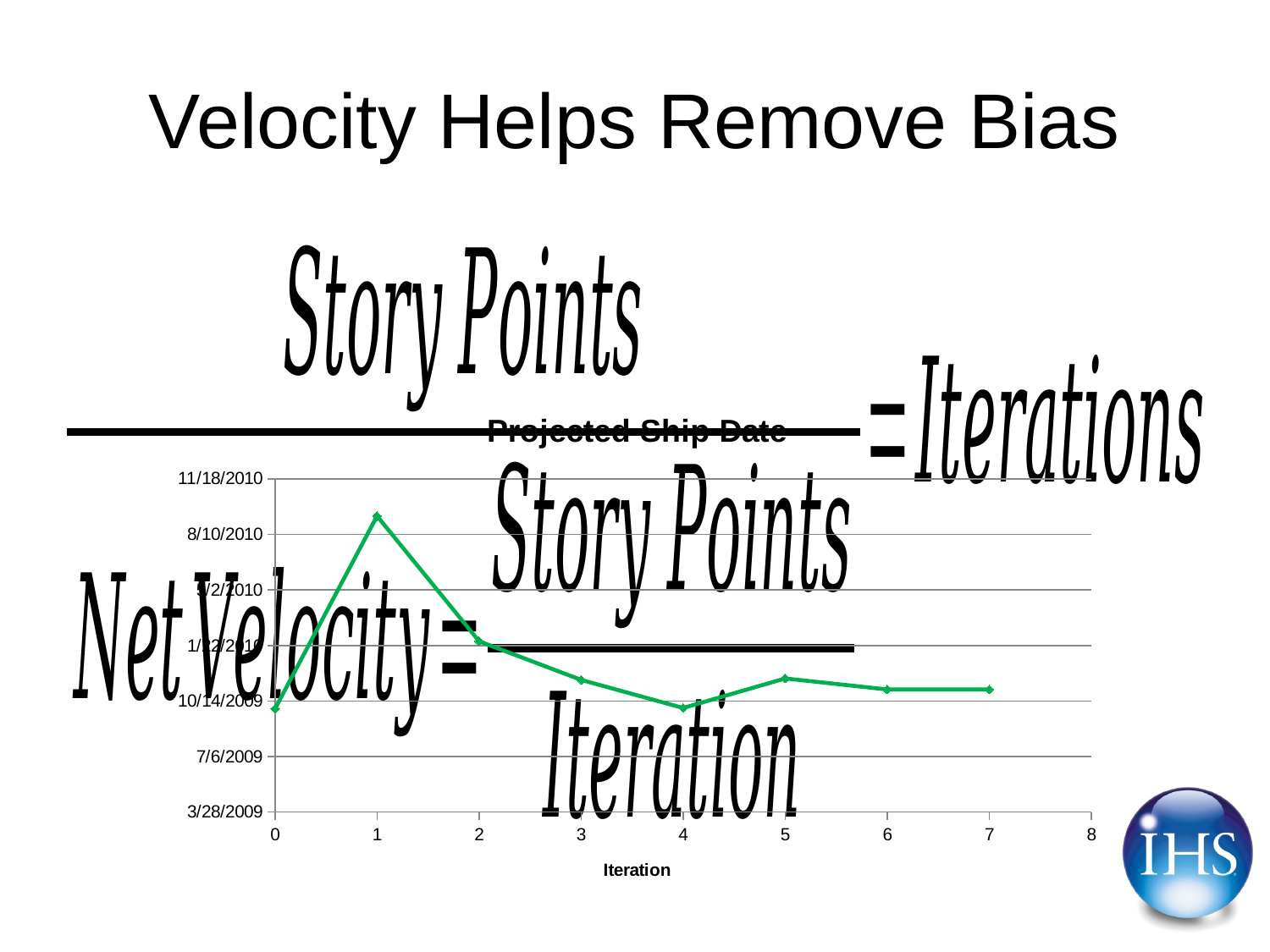
Is the projected ship date at iteration 1 greater or less than 5/2/2010? greater Is the projected ship date at iteration 7 greater or less than 7/6/2009? greater Which has the later projected ship date, iteration 3 or iteration 4? iteration 3 How many data points are plotted on the line? 8 Does the projected ship date rise or fall from iteration 1 to iteration 4? fall Is the projected ship date at iteration 3 greater or less than 1/22/2010? less What kind of chart is shown on the slide? line chart At which iteration is the projected ship date the latest (highest point)? 1 What is the title of the chart? Projected Ship Date What is the label of the x axis of the chart? Iteration Which has the later projected ship date, iteration 1 or iteration 2? iteration 1